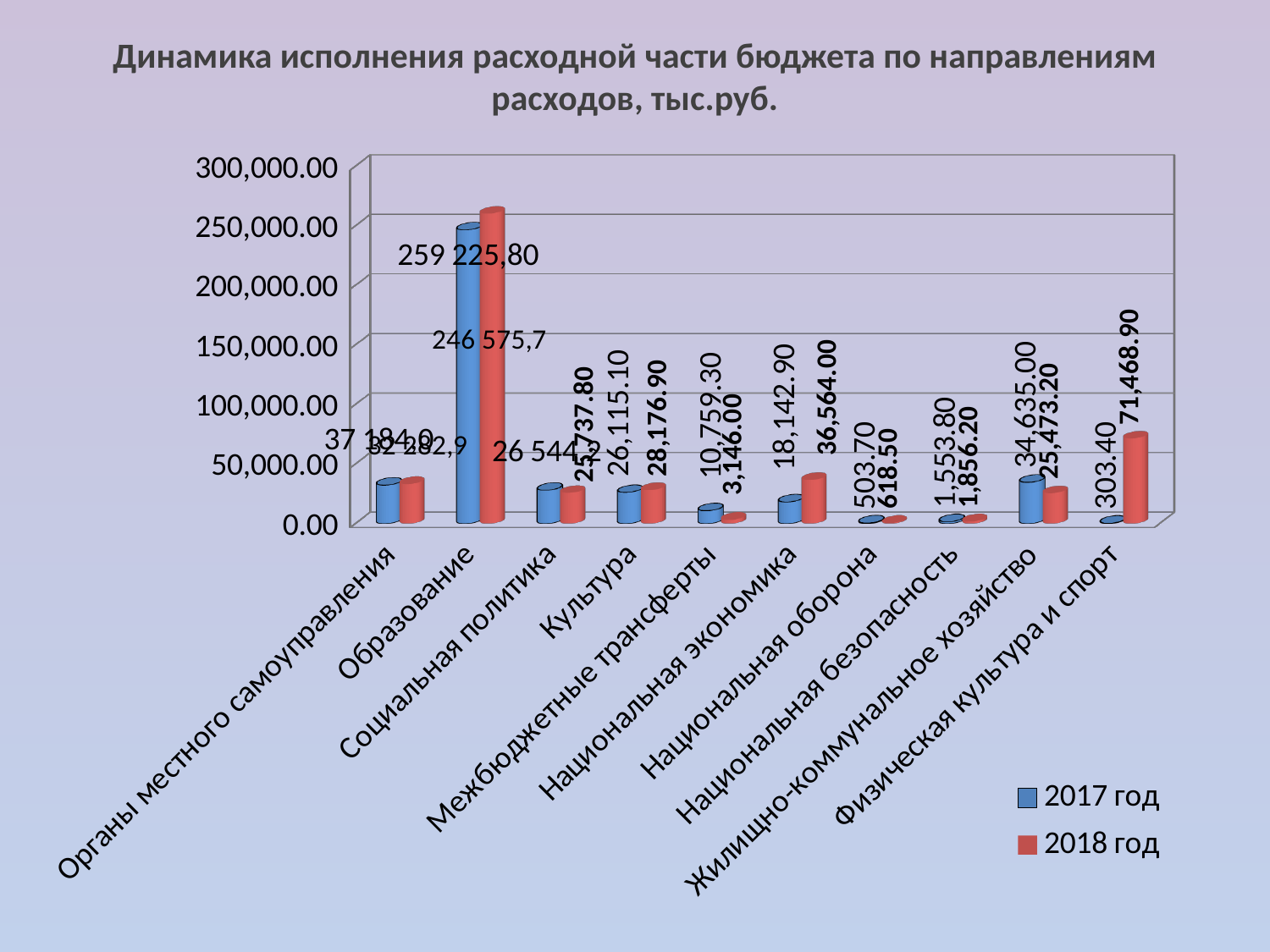
What is the value for Физическая культура и спорт in the 2018 год series? 71,468.90 What is the value for Культура in the 2017 год series? 26,115.10 What is the value for Межбюджетные трансферты in the 2017 год series? 10,759.30 For Жилищно-коммунальное хозяйство, which series has the larger value, 2017 год or 2018 год? 2017 год What is the value for Национальная оборона in the 2018 год series? 618.50 Which category has the lowest value in the 2017 год series? Физическая культура и спорт How many series does the legend list? 2 Which category has the highest value in the 2018 год series? Образование Is the 2018 год value for Физическая культура и спорт greater or less than 50,000.00? greater What is the difference between the 2018 год and 2017 год values for Культура? 2,061.80 What is the value for Национальная экономика in the 2018 год series? 36,564.00 How many categories are shown on the x axis? 10